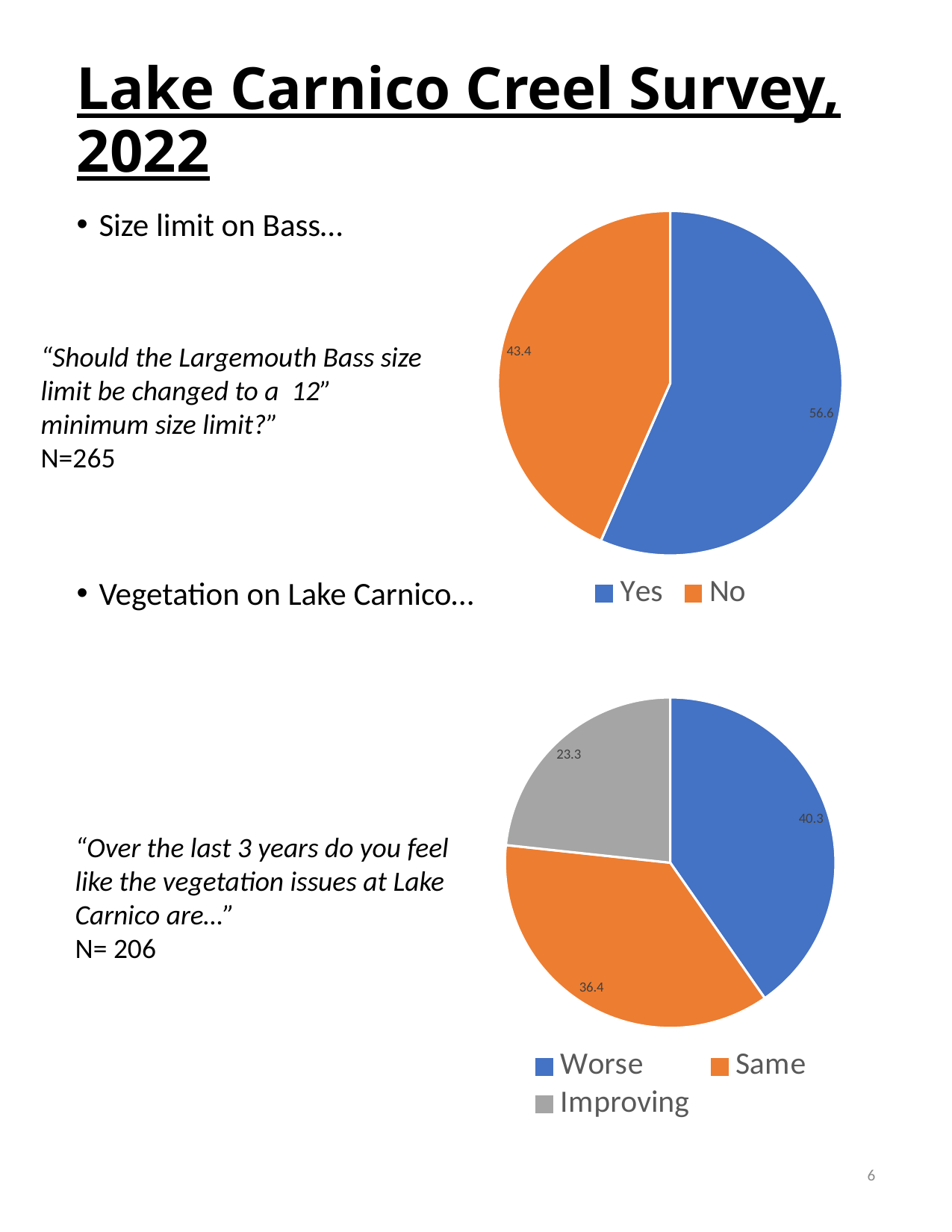
In the top pie chart, what is the value for No? 43.4 What type of chart is the bottom chart on the slide? Pie chart How many slices does the bottom pie chart have? 3 In the bottom pie chart, which category has the smallest slice? Improving In the bottom pie chart, which category has the largest slice? Worse In the top pie chart, what is the value for Yes? 56.6 In the bottom pie chart, what is the value for Improving? 23.3 In the bottom pie chart, what is the value for Worse? 40.3 In the bottom pie chart, what is the value for Same? 36.4 How many entries does the legend of the top pie chart list? 2 In the top pie chart, which slice is larger, Yes or No? Yes In the top pie chart, what is the difference between the Yes and No values? 13.2